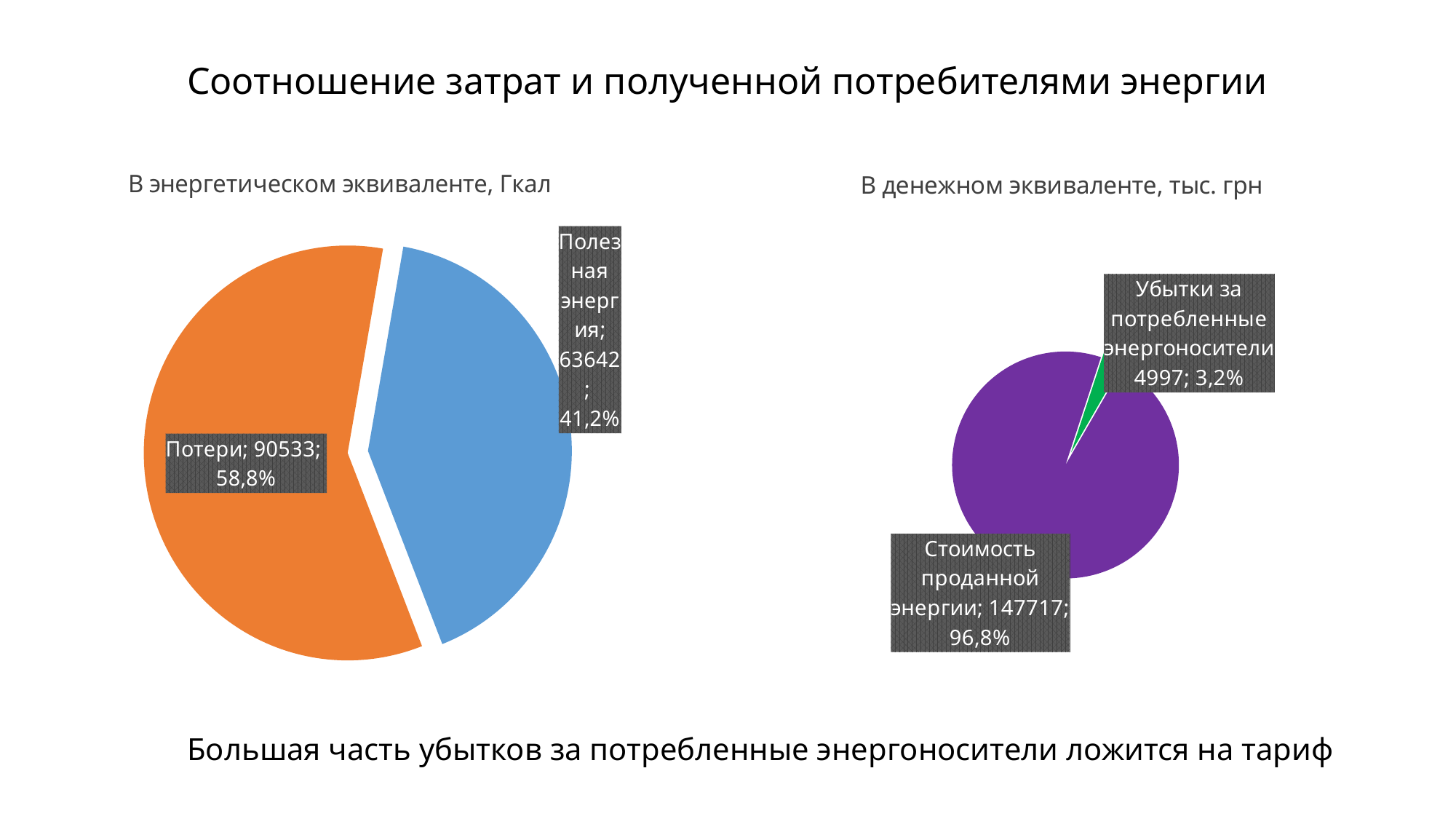
In the chart 'В денежном эквиваленте, тыс. грн', what share of the pie is Убытки за потребленные энергоносители? 3,2% In the chart 'В денежном эквиваленте, тыс. грн', how many slices does the pie have? 2 In the chart 'В денежном эквиваленте, тыс. грн', what is the value for Стоимость проданной энергии? 147717 In the chart 'В денежном эквиваленте, тыс. грн', which slice is the smallest? Убытки за потребленные энергоносители What type of chart is the left chart 'В энергетическом эквиваленте, Гкал'? Pie chart In the chart 'В энергетическом эквиваленте, Гкал', what is the value for Потери? 90533 In the chart 'В энергетическом эквиваленте, Гкал', what is the value for Полезная энергия? 63642 In the chart 'В энергетическом эквиваленте, Гкал', which slice is the largest? Потери In the chart 'В энергетическом эквиваленте, Гкал', what share of the pie is Потери? 58,8% In the chart 'В денежном эквиваленте, тыс. грн', what is the value for Убытки за потребленные энергоносители? 4997 In the chart 'В энергетическом эквиваленте, Гкал', what is the difference between Потери and Полезная энергия? 26891 What colour is the Потери slice in the chart 'В энергетическом эквиваленте, Гкал'? Orange